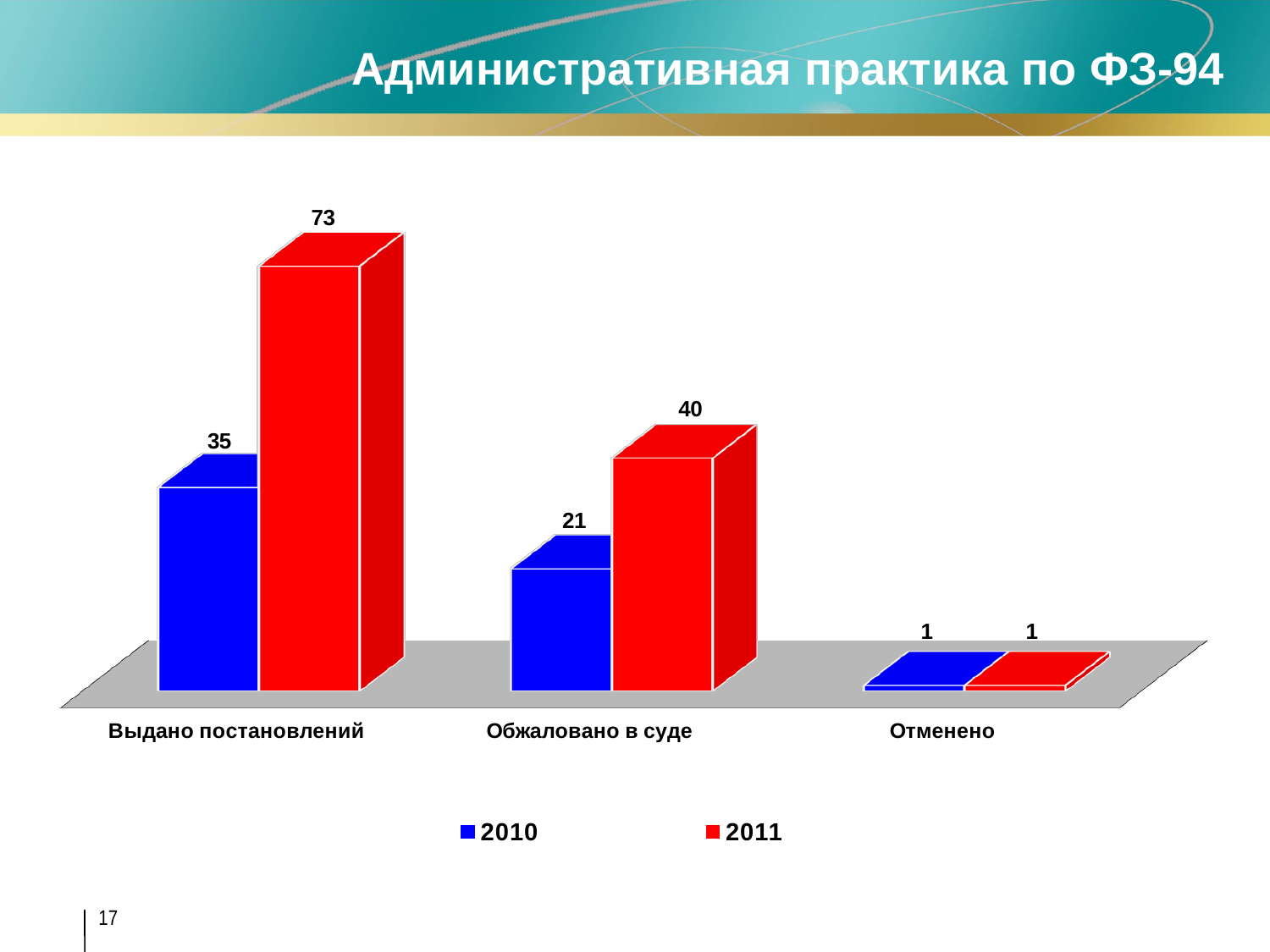
What is the value for 2010 in the "Обжаловано в суде" category? 21 What is the value for 2011 in the "Выдано постановлений" category? 73 How many series does the legend list? 2 How many categories are shown on the x axis? 3 What is the difference between the 2011 and 2010 values for "Выдано постановлений"? 38 What is the difference between the 2011 and 2010 values for "Обжаловано в суде"? 19 What kind of chart is shown on the slide? Bar chart What is the value for 2010 in the "Отменено" category? 1 Which category has the highest value for the 2011 series? Выдано постановлений Which colour represents the 2011 series in the legend? Red Which is larger for "Обжаловано в суде": the 2010 value or the 2011 value? 2011 Which category has the lowest value for the 2010 series? Отменено